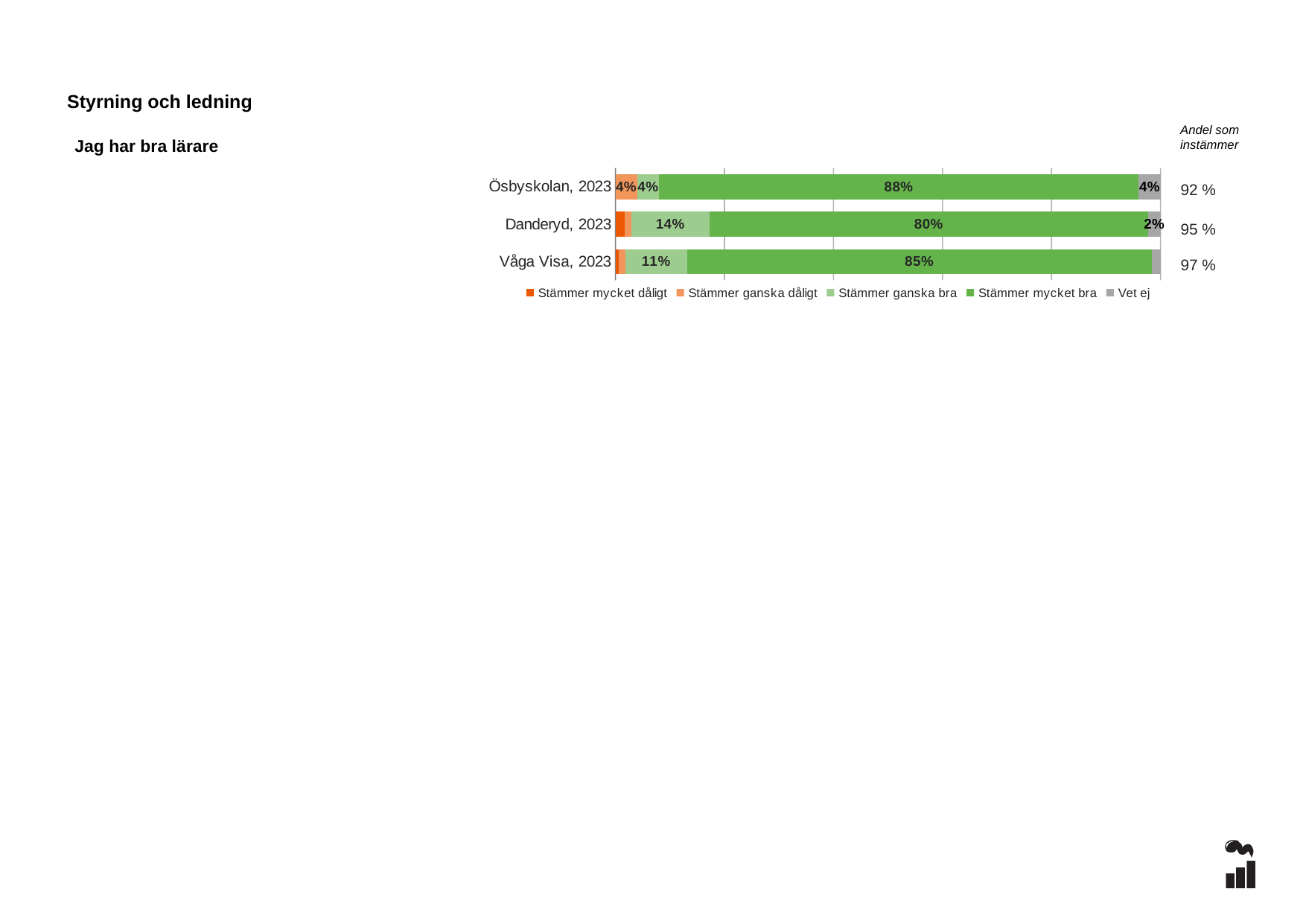
What is the "Andel som instämmer" value shown for Våga Visa, 2023? 97 % How many categories (rows) are plotted in the chart? 3 What is the value of "Vet ej" for Danderyd, 2023? 2% What is the difference in "Stämmer mycket bra" between Ösbyskolan, 2023 and Danderyd, 2023? 8 percentage points Which has the larger "Stämmer ganska bra" value, Danderyd, 2023 or Våga Visa, 2023? Danderyd, 2023 What is the value of "Stämmer ganska bra" for Danderyd, 2023? 14% Which category has the highest value for "Stämmer mycket bra"? Ösbyskolan, 2023 Which category has the lowest value for "Stämmer ganska bra"? Ösbyskolan, 2023 What kind of chart is shown on the slide? bar chart How many series does the legend list? 5 What is the value of "Stämmer mycket bra" for Ösbyskolan, 2023? 88% What is the value of "Stämmer mycket bra" for Våga Visa, 2023? 85%